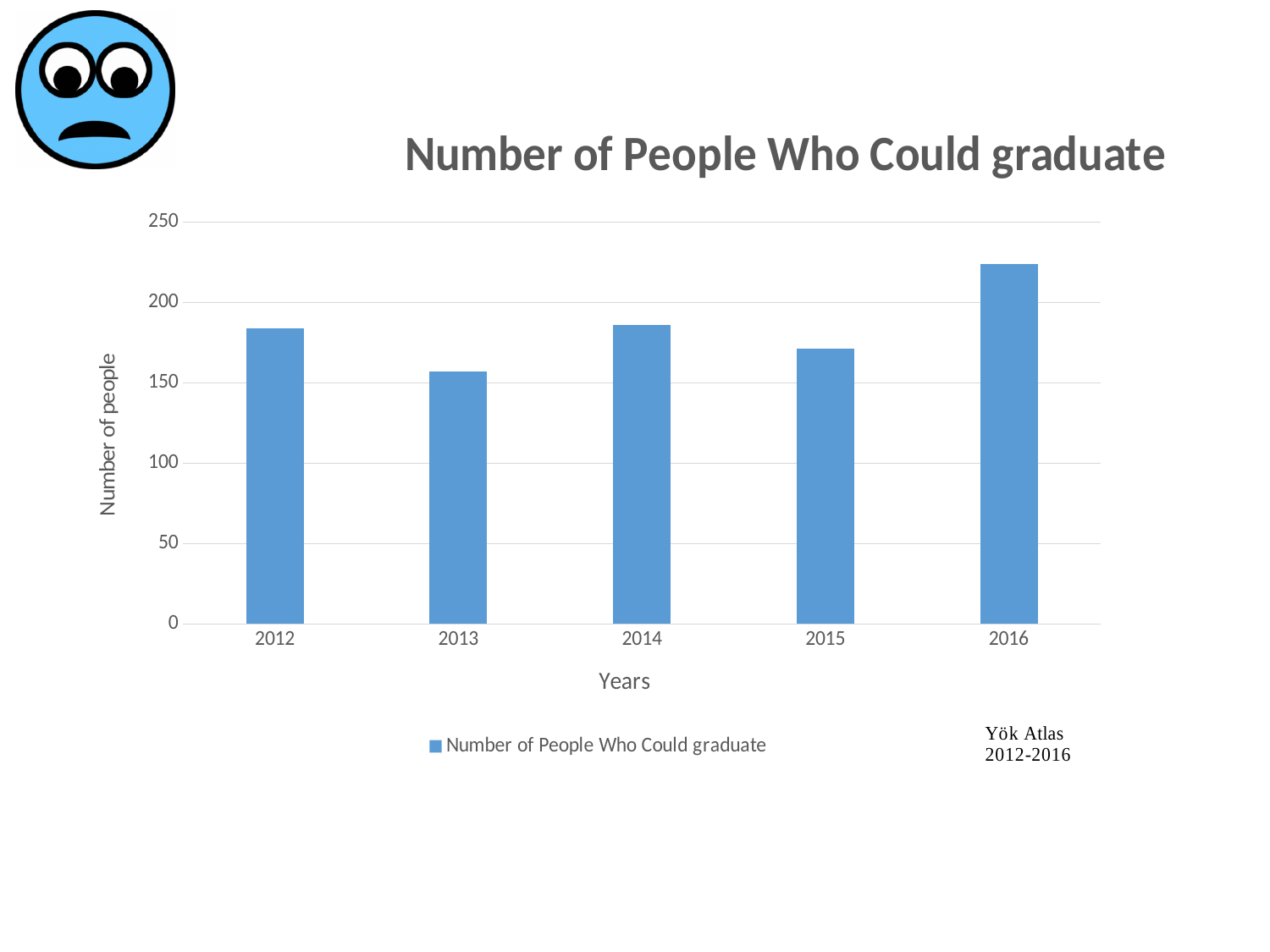
Is the value for 2013 greater or less than 200? less What is the title of the chart? Number of People Who Could graduate Is the value for 2012 greater or less than 150? greater Is the value for 2015 greater or less than 200? less Which year has the highest number of people who could graduate? 2016 How many series does the legend list? 1 What type of chart is shown on the slide? bar chart How many years are shown on the x axis of the chart? 5 What is the label of the y axis? Number of people Which is larger, the value for 2013 or the value for 2015? 2015 Which year has the lowest number of people who could graduate? 2013